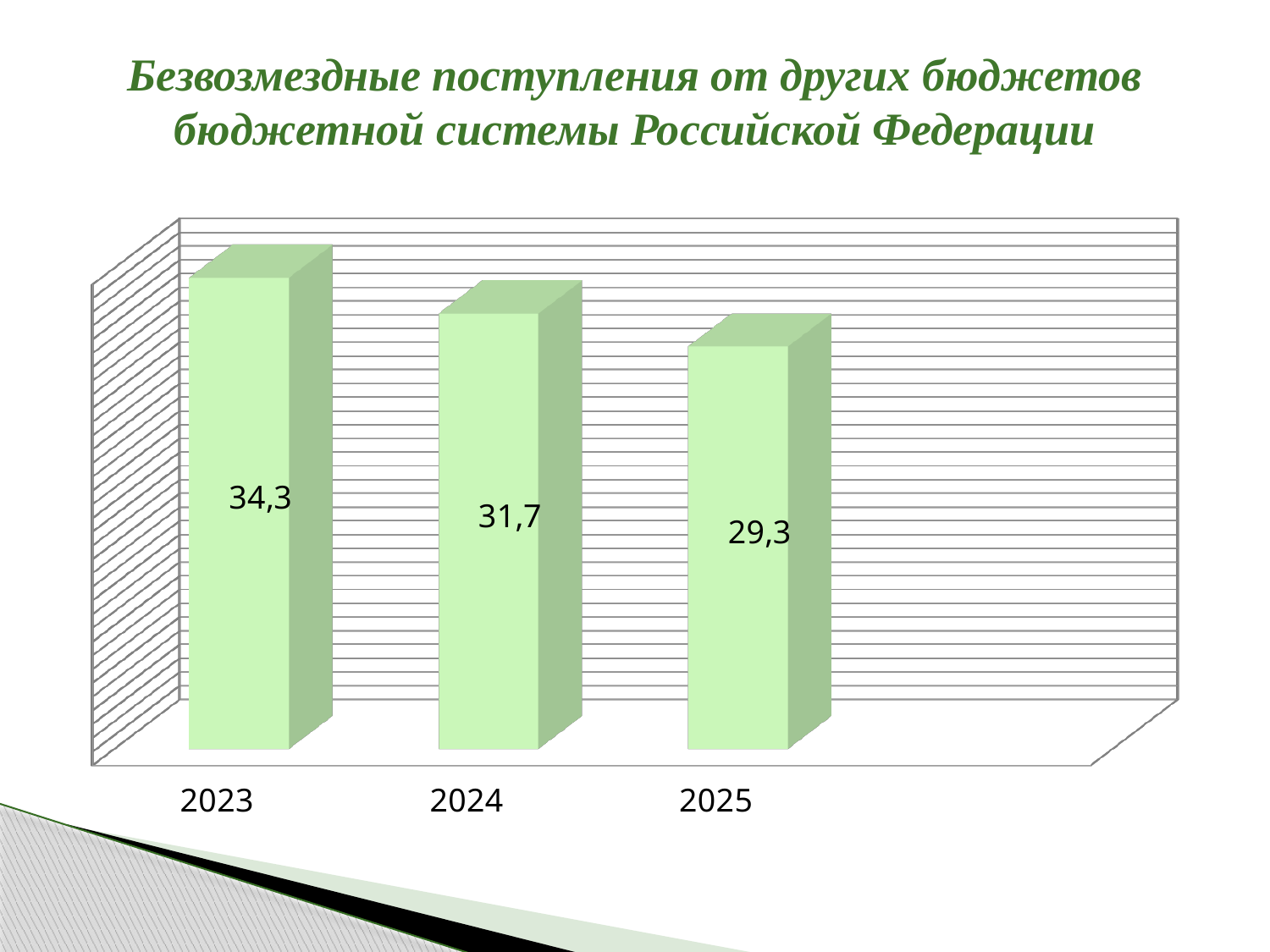
Which year has the lowest value? 2025 Which is larger, the value for 2024 or the value for 2025? 2024 What is the value for 2025? 29,3 What kind of chart is shown on the slide? bar chart How many years are shown on the chart? 3 What is the value for 2024? 31,7 Do the values rise or fall from 2023 to 2025? fall What is the title of the chart? Безвозмездные поступления от других бюджетов бюджетной системы Российской Федерации What is the value for 2023? 34,3 What is the difference between the values for 2023 and 2025? 5,0 What is the difference between the values for 2023 and 2024? 2,6 Which year has the highest value? 2023